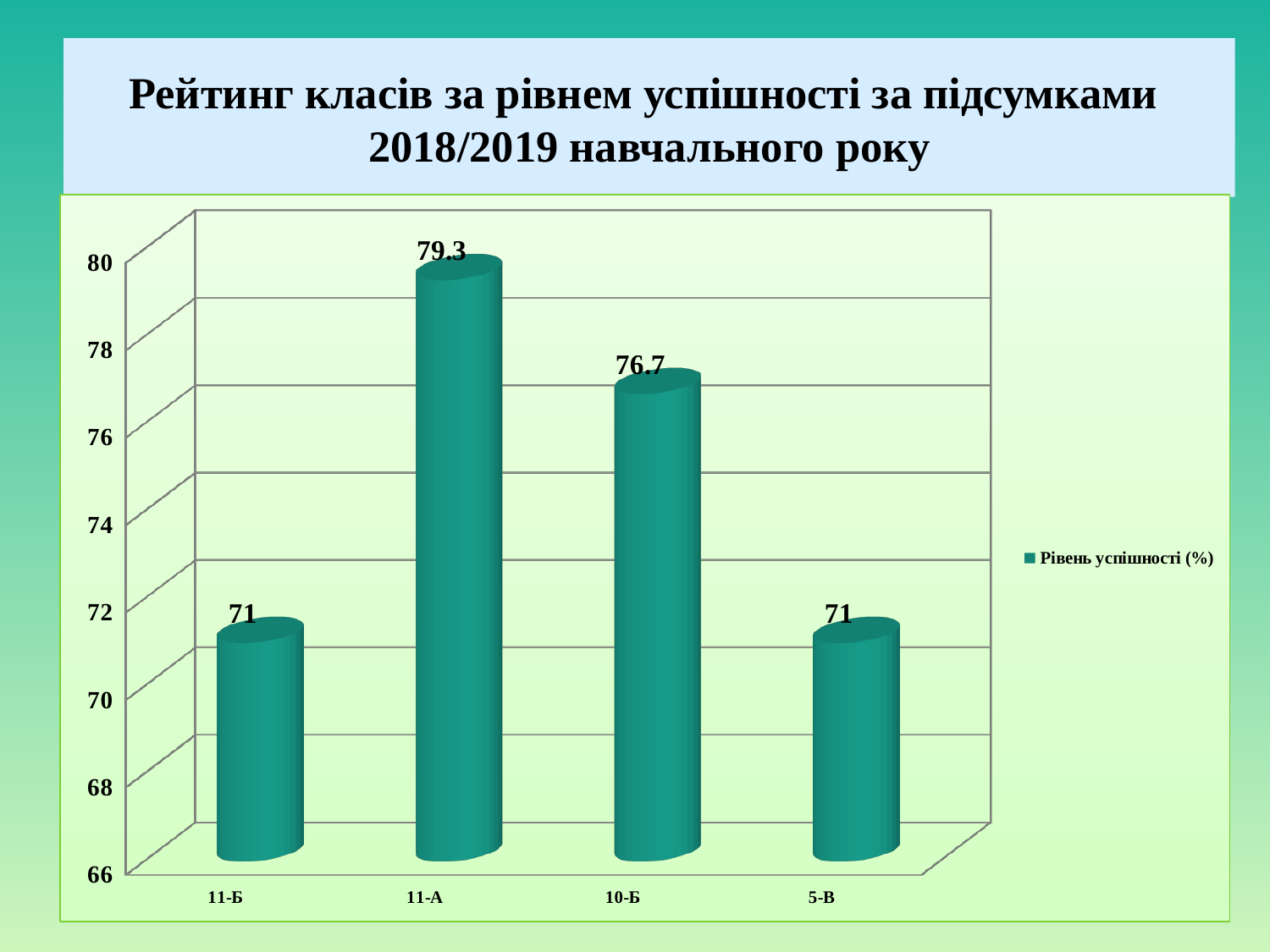
How many series does the legend list? 1 Which class has the highest value? 11-А What is the value for 11-Б? 71 What is the value for 11-А? 79.3 What kind of chart is shown on the slide? bar chart Which is larger, the value for 11-А or the value for 10-Б? 11-А How many classes are shown on the chart? 4 What is the legend entry of the chart? Рівень успішності (%) What is the value for 10-Б? 76.7 What is the difference between the values for 10-Б and 5-В? 5.7 What is the difference between the values for 11-А and 10-Б? 2.6 Is the value for 10-Б greater or less than 74? greater